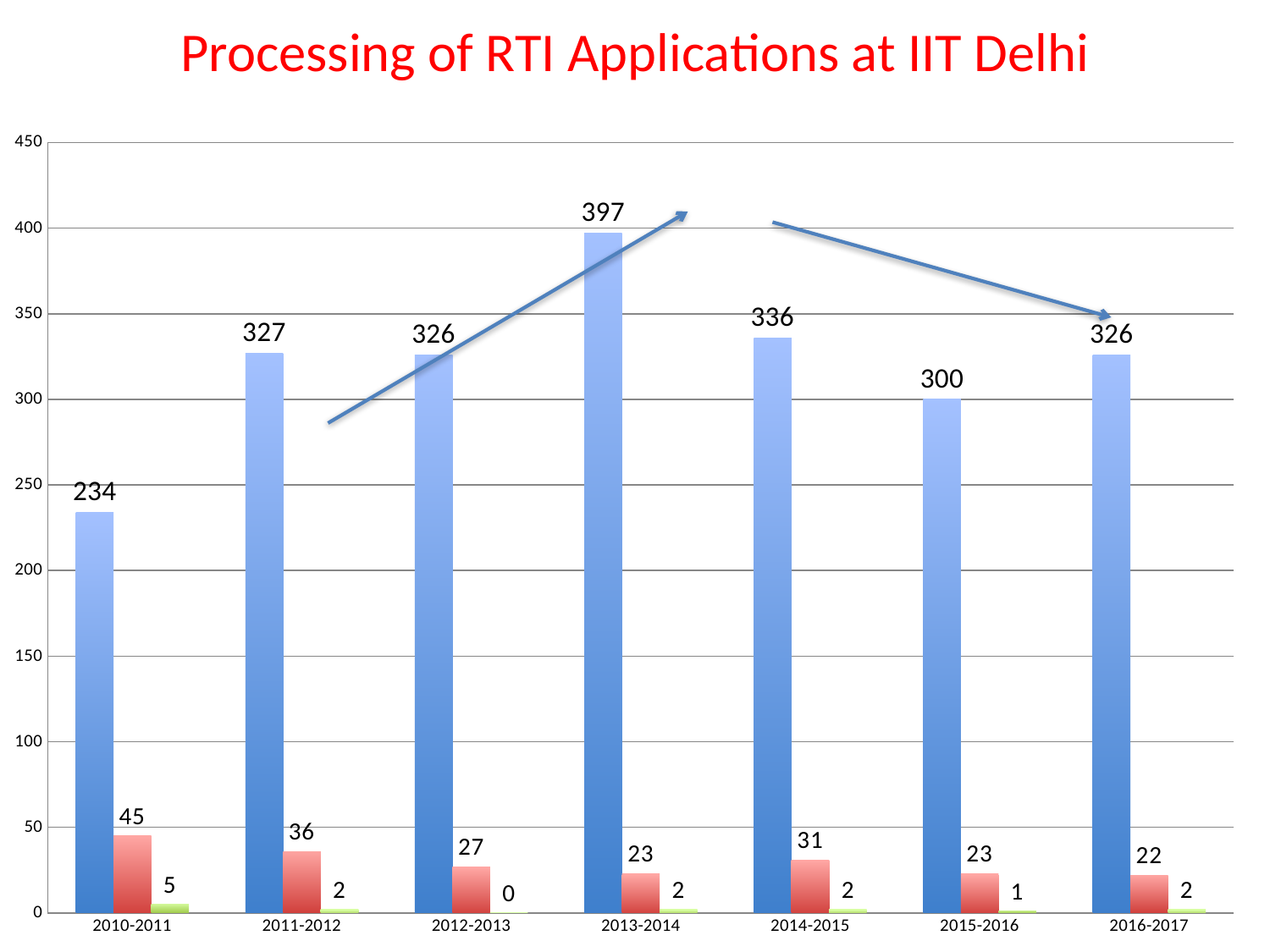
What is the difference between the blue bar values for 2013-2014 and 2014-2015? 61 Which is larger, the blue bar for 2011-2012 or the blue bar for 2015-2016? 2011-2012 What is the value of the red bar for 2010-2011? 45 What is the value of the green bar for 2015-2016? 1 How many years are shown on the x axis? 7 Is the blue bar for 2010-2011 greater or less than 250? less What kind of chart is shown on the slide? bar chart Which year has the lowest red bar? 2016-2017 Which year has the lowest blue bar? 2010-2011 What is the value of the blue bar for 2013-2014? 397 What is the title of the chart? Processing of RTI Applications at IIT Delhi Which year has the highest blue bar? 2013-2014